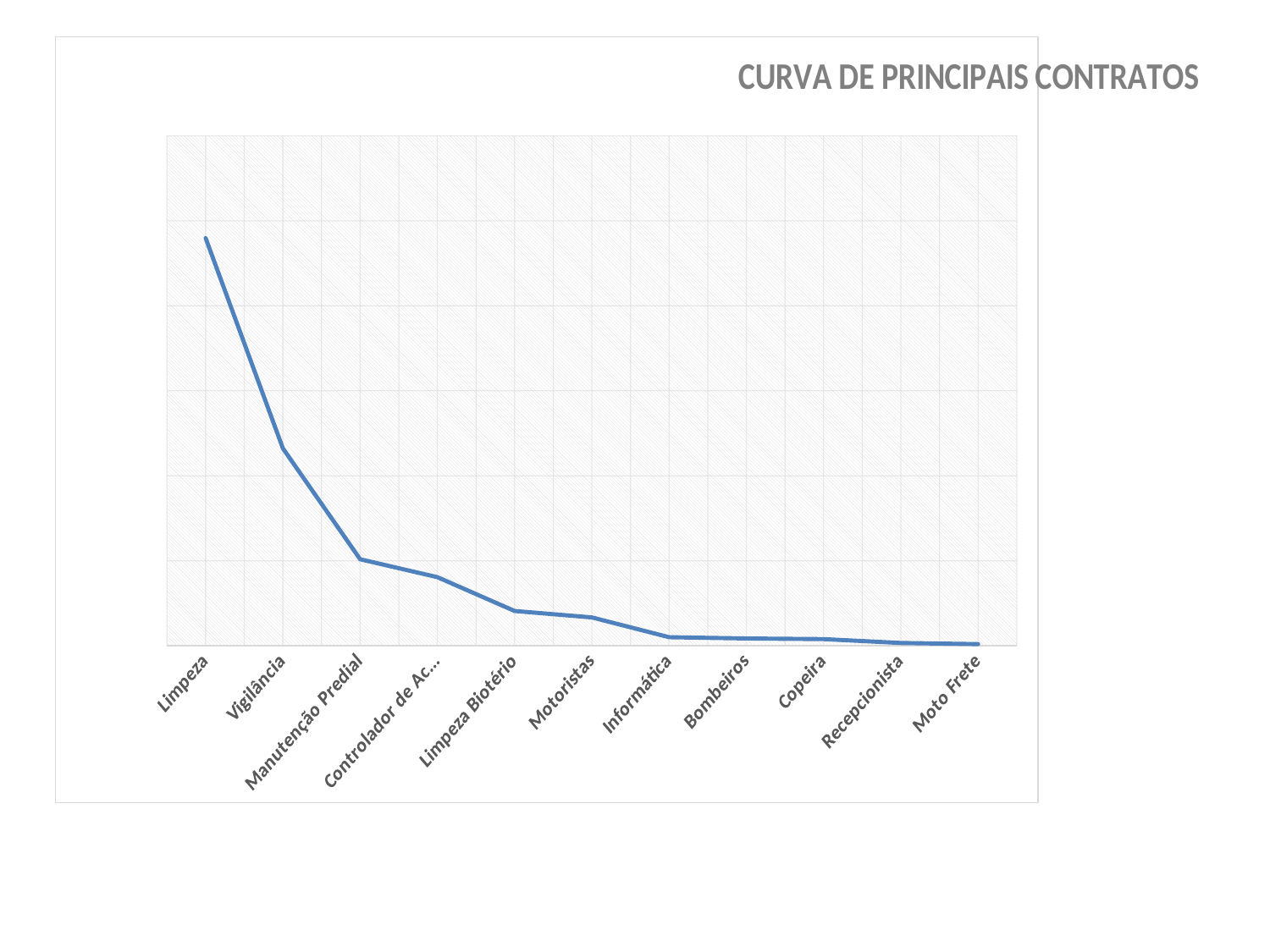
Which category has the highest value in the chart? Limpeza What is the first category on the x axis of the chart? Limpeza Which is larger, the value for Vigilância or the value for Motoristas? Vigilância Which is larger, the value for Limpeza or the value for Vigilância? Limpeza Which is larger, the value for Controlador de Ac... or the value for Informática? Controlador de Ac... What kind of chart is shown on the slide? line chart Do the values rise or fall moving from left to right along the x axis? fall How many categories are shown along the x axis of the chart? 11 What is the title of the chart? CURVA DE PRINCIPAIS CONTRATOS How many lines are plotted in the chart? 1